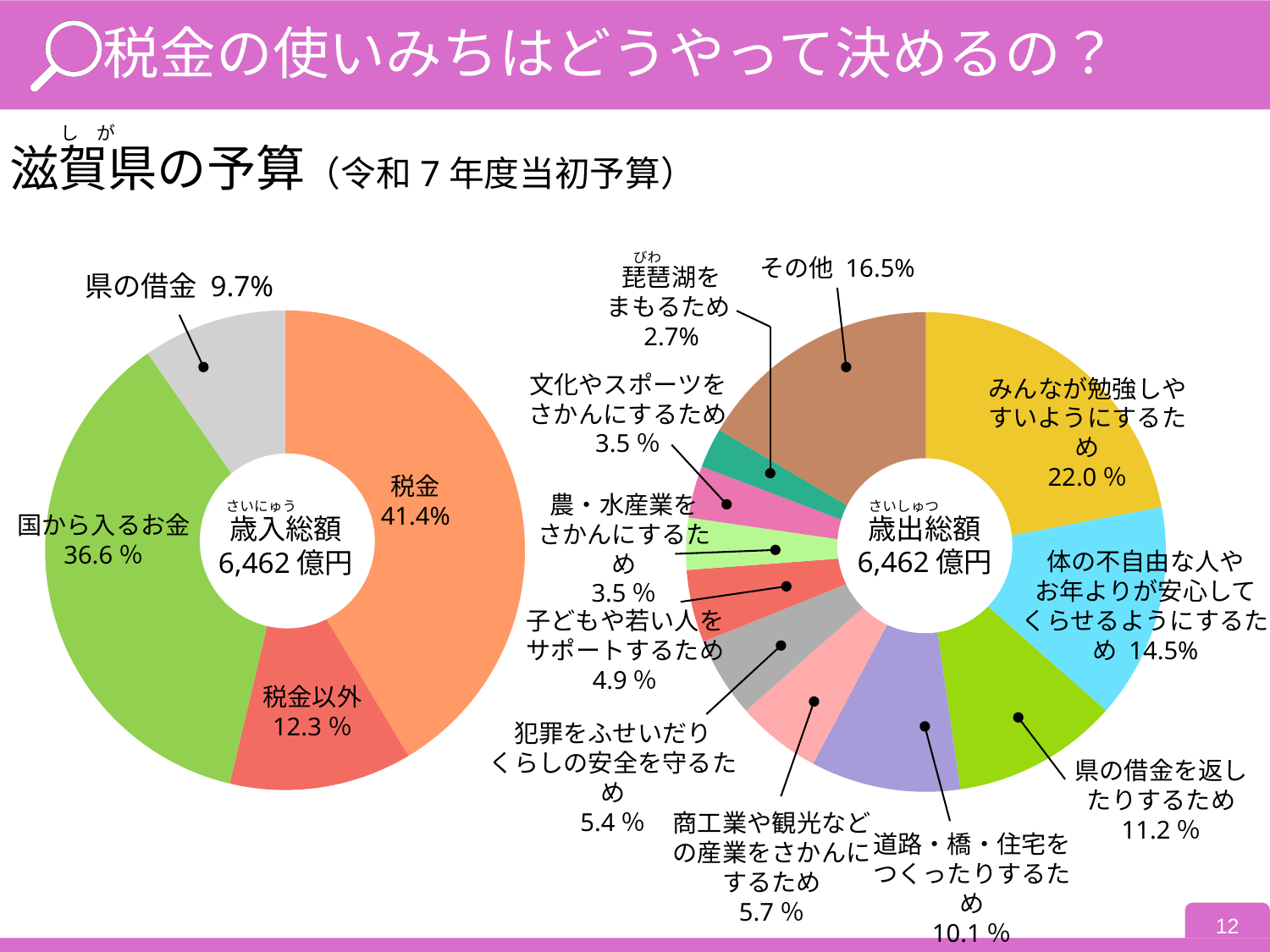
In the left chart (歳入総額), how many slices are there? 4 In the right chart (歳出総額), what share is 琵琶湖をまもるため? 2.7% What total amount is shown in the centre of the left chart (歳入総額)? 6,462 億円 In the right chart (歳出総額), what share is みんなが勉強しやすいようにするため? 22.0 % In the right chart (歳出総額), which is larger: 県の借金を返したりするため or 道路・橋・住宅をつくったりするため? 県の借金を返したりするため In the left chart (歳入総額), what share is 国から入るお金? 36.6 % In the left chart (歳入総額), which category has the smallest share? 県の借金 What kind of chart is used on this slide? Pie (donut) chart In the left chart (歳入総額), what share is 税金? 41.4% In the right chart (歳出総額), which labelled purpose (excluding その他) has the largest share? みんなが勉強しやすいようにするため In the right chart (歳出総額), how many slices are there? 11 In the left chart (歳入総額), what is the difference between the shares of 税金 and 税金以外? 29.1%